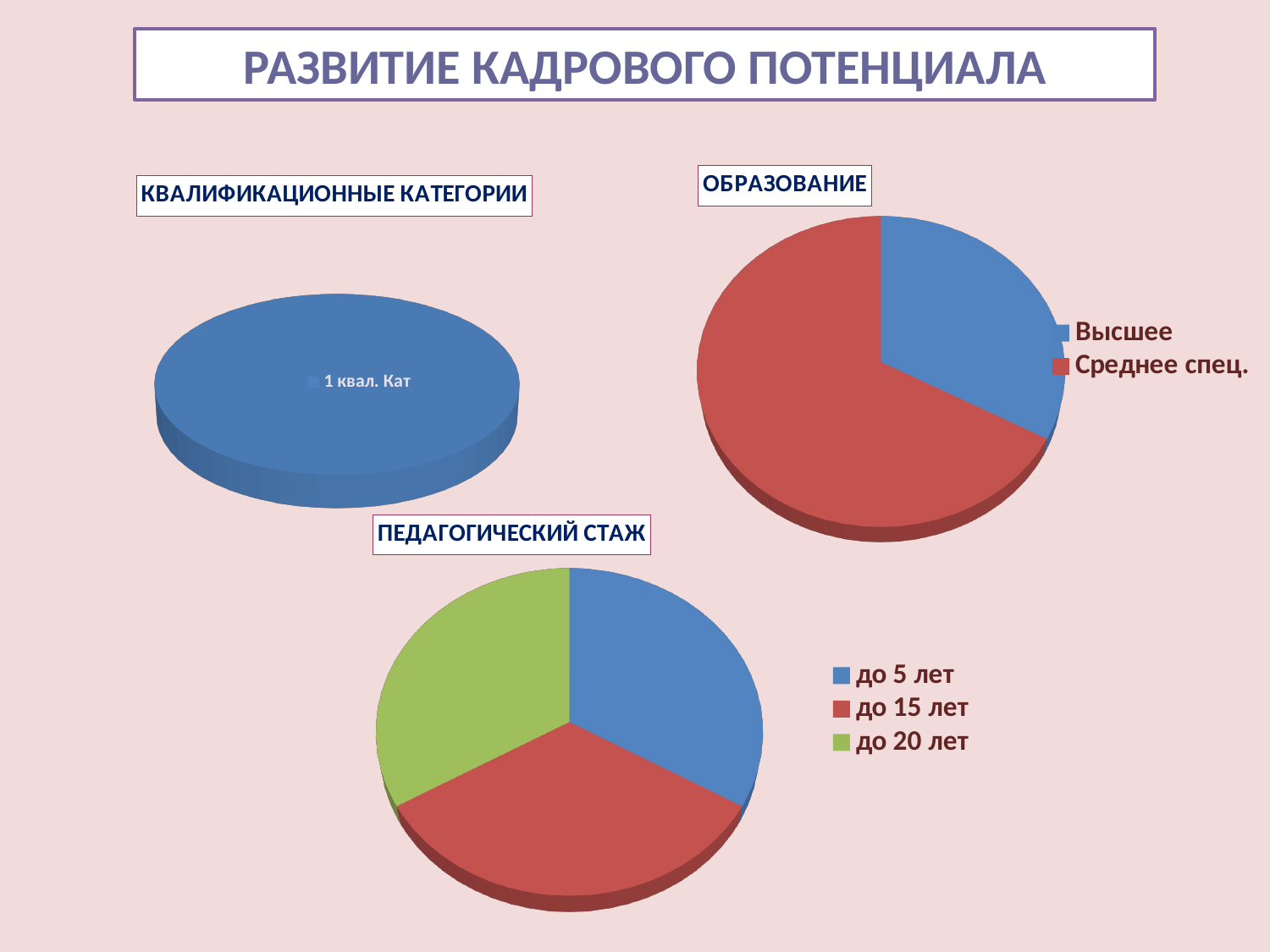
What is the only category label shown in the "КВАЛИФИКАЦИОННЫЕ КАТЕГОРИИ" chart? 1 квал. Кат How many slices does the "ОБРАЗОВАНИЕ" pie chart have? 2 How many categories does the "КВАЛИФИКАЦИОННЫЕ КАТЕГОРИИ" chart show? 1 In the "ОБРАЗОВАНИЕ" chart, which category has the smallest slice? Высшее How many entries does the legend of the "ПЕДАГОГИЧЕСКИЙ СТАЖ" chart list? 3 What kind of chart is the "ПЕДАГОГИЧЕСКИЙ СТАЖ" chart? pie chart In the "ПЕДАГОГИЧЕСКИЙ СТАЖ" chart, which category is shown in green? до 20 лет How many slices does the "ПЕДАГОГИЧЕСКИЙ СТАЖ" pie chart have? 3 In the "ОБРАЗОВАНИЕ" chart, which slice is larger: "Высшее" or "Среднее спец."? Среднее спец. In the "ОБРАЗОВАНИЕ" chart, which category has the largest slice? Среднее спец. What kind of chart is the "ОБРАЗОВАНИЕ" chart? pie chart